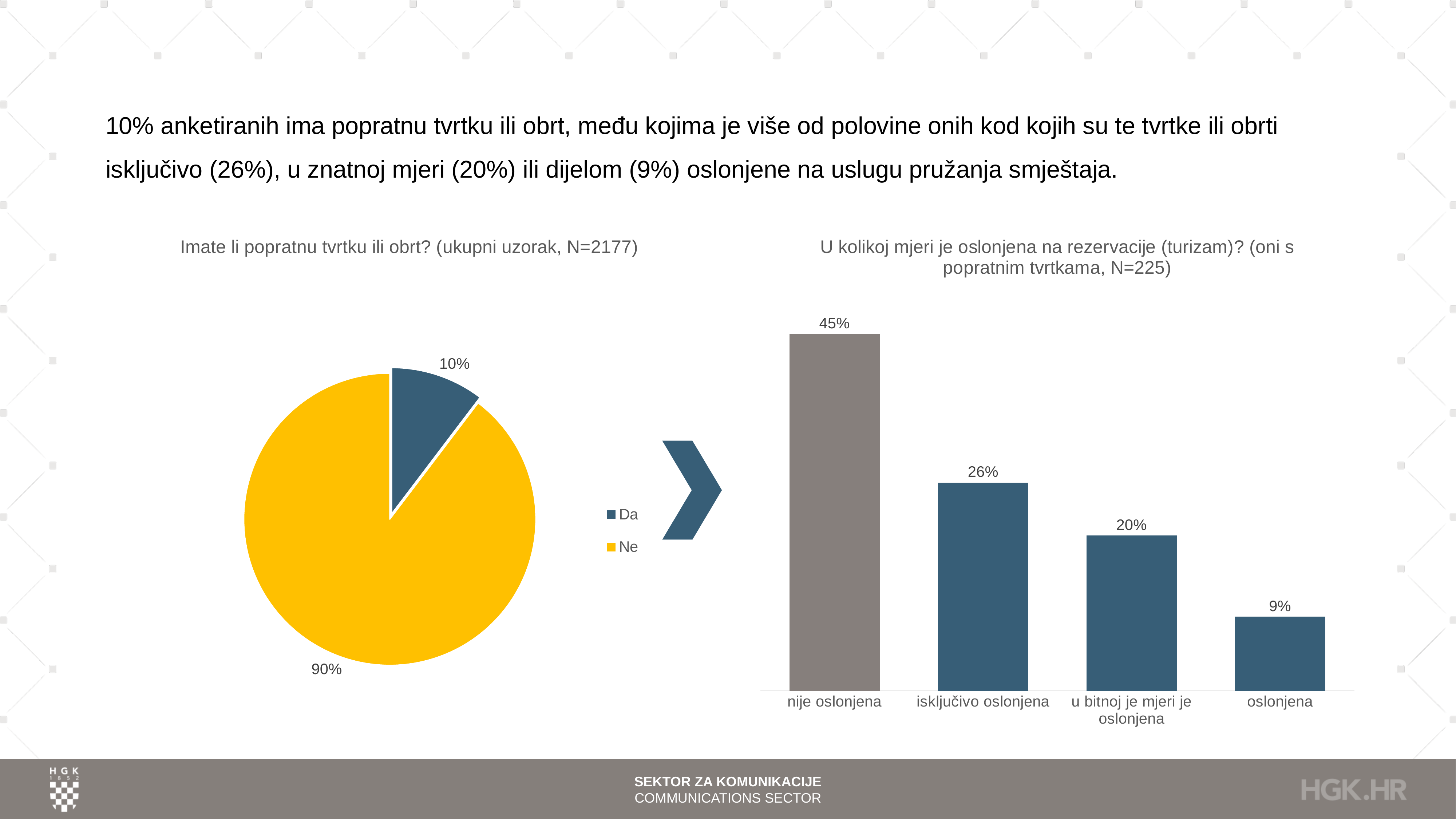
How many bars are in the bar chart on the right? 4 In the bar chart on the right, what is the value for "nije oslonjena"? 45% In the pie chart on the left, what share of respondents answered "Da"? 10% In the pie chart on the left, which category has the larger slice, "Da" or "Ne"? Ne What kind of chart is the chart on the left of the slide? pie chart In the bar chart on the right, which category has the highest value? nije oslonjena In the bar chart on the right, what is the difference between the values for "nije oslonjena" and "u bitnoj je mjeri je oslonjena"? 25% In the bar chart on the right, what is the value for "isključivo oslonjena"? 26% What kind of chart is the chart on the right of the slide? bar chart In the bar chart on the right, which category has the lowest value? oslonjena In the pie chart on the left, what share of respondents answered "Ne"? 90% How many entries does the legend of the pie chart on the left list? 2